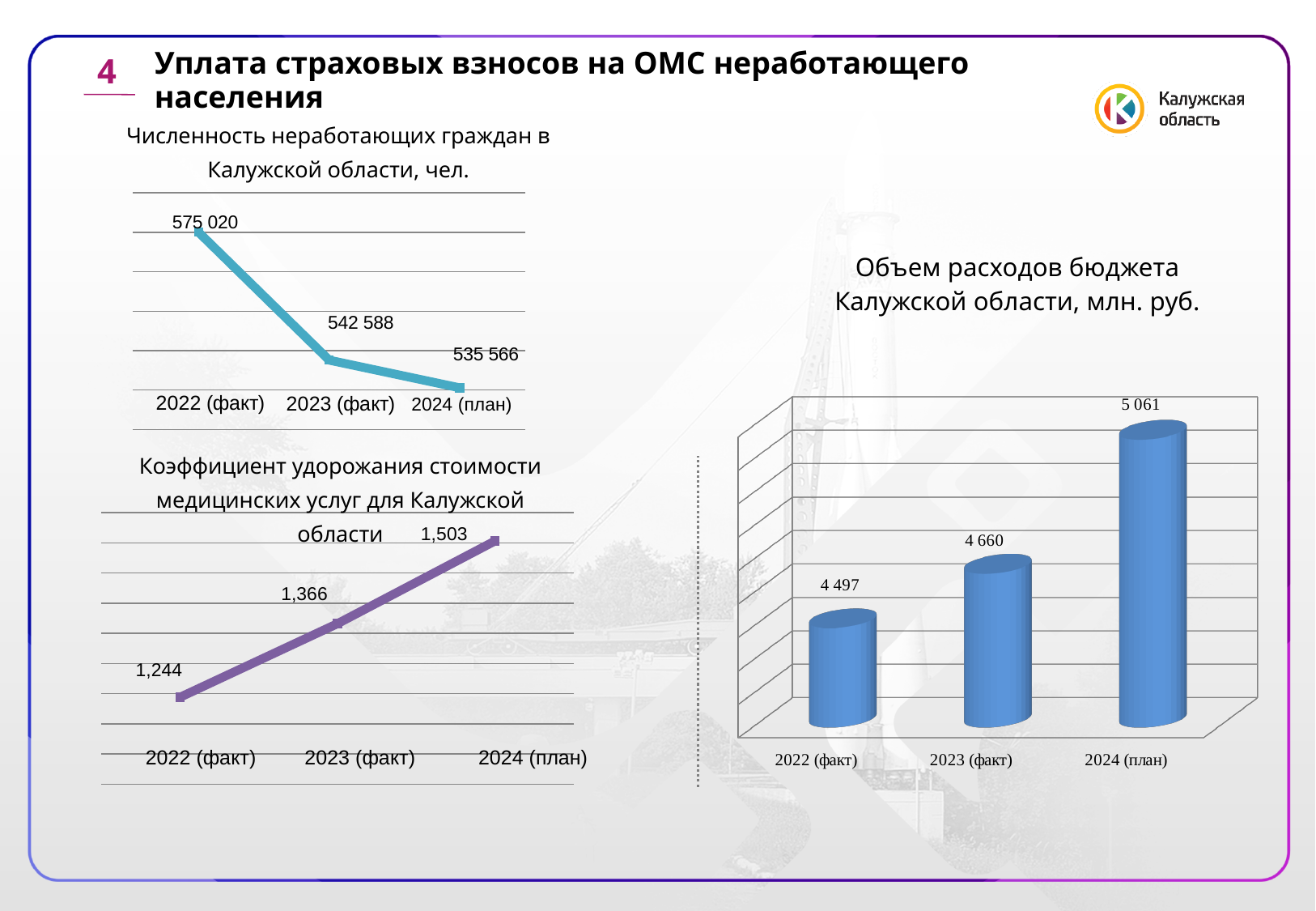
In the chart 'Коэффициент удорожания стоимости медицинских услуг для Калужской области', what is the value for 2023 (факт)? 1,366 In the chart 'Численность неработающих граждан в Калужской области, чел.', which year has the lowest value? 2024 (план) In the chart 'Объем расходов бюджета Калужской области, млн. руб.', what is the value for 2024 (план)? 5 061 In the chart 'Численность неработающих граждан в Калужской области, чел.', what is the value for 2022 (факт)? 575 020 In the chart 'Коэффициент удорожания стоимости медицинских услуг для Калужской области', which year has the highest value? 2024 (план) What kind of chart is 'Объем расходов бюджета Калужской области, млн. руб.'? bar chart In the chart 'Объем расходов бюджета Калужской области, млн. руб.', which is larger: 2022 (факт) or 2023 (факт)? 2023 (факт) In the chart 'Коэффициент удорожания стоимости медицинских услуг для Калужской области', do the values rise or fall from 2022 to 2024? rise How many data points are plotted in the chart 'Объем расходов бюджета Калужской области, млн. руб.'? 3 In the chart 'Численность неработающих граждан в Калужской области, чел.', what is the difference between the 2022 (факт) and 2023 (факт) values? 32 432 In the chart 'Объем расходов бюджета Калужской области, млн. руб.', what is the difference between the 2024 (план) and 2022 (факт) values? 564 In the chart 'Численность неработающих граждан в Калужской области, чел.', do the values rise or fall from 2022 to 2024? fall